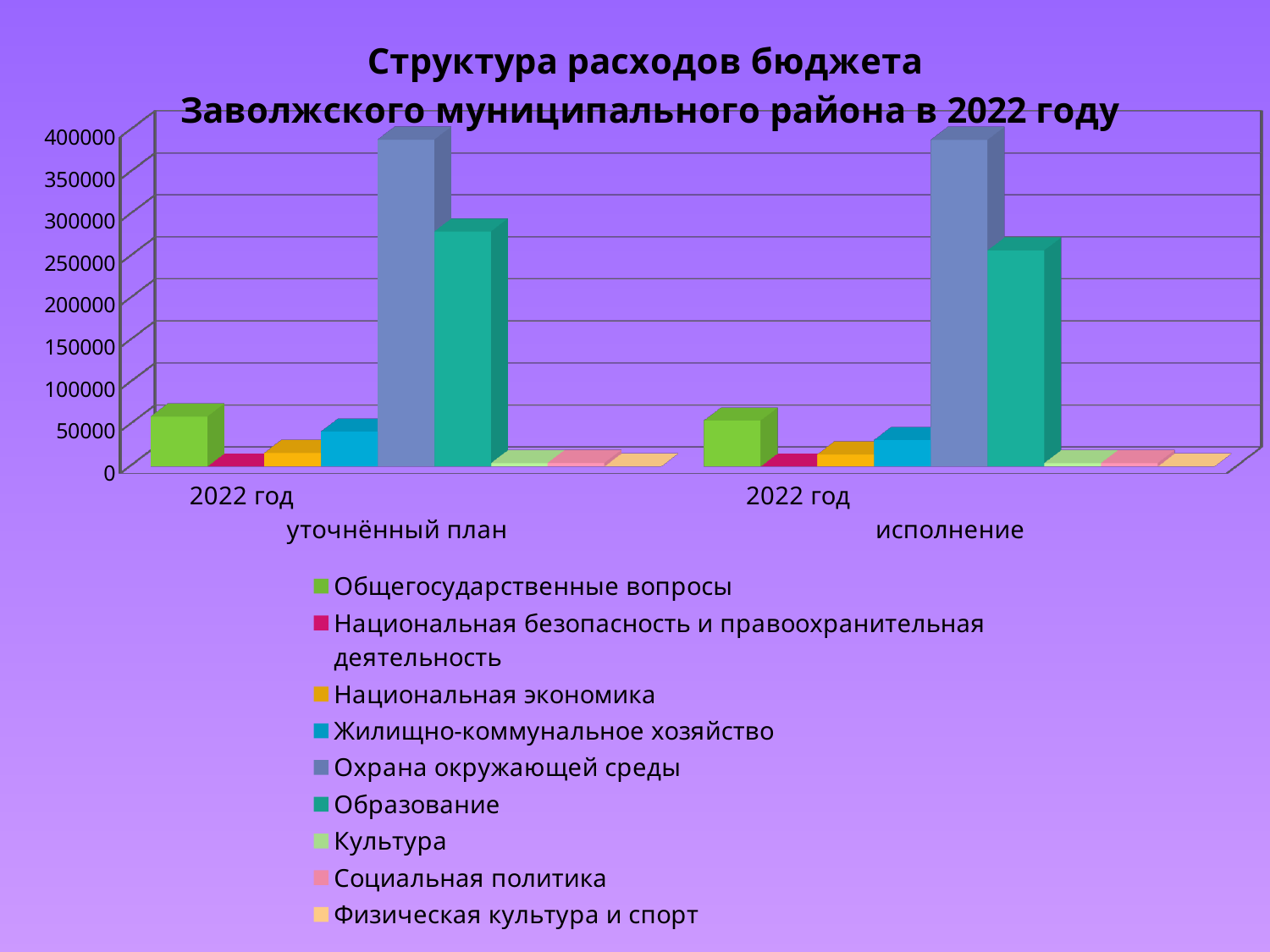
What is the title of the chart? Структура расходов бюджета Заволжского муниципального района в 2022 году What kind of chart is shown on the slide? bar chart Which series has the highest value in the "2022 год исполнение" group? Охрана окружающей среды In the "2022 год уточнённый план" group, which is larger: Образование or Общегосударственные вопросы? Образование How many series does the legend list? 9 How many category groups are shown along the x axis? 2 Is the value for Общегосударственные вопросы in the "2022 год уточнённый план" group greater or less than 100000? less Is the value for Охрана окружающей среды in the "2022 год уточнённый план" group greater or less than 350000? greater Is the value for Образование in the "2022 год исполнение" group greater or less than 200000? greater Which series has the highest value in the "2022 год уточнённый план" group? Охрана окружающей среды In the "2022 год исполнение" group, which is larger: Охрана окружающей среды or Образование? Охрана окружающей среды